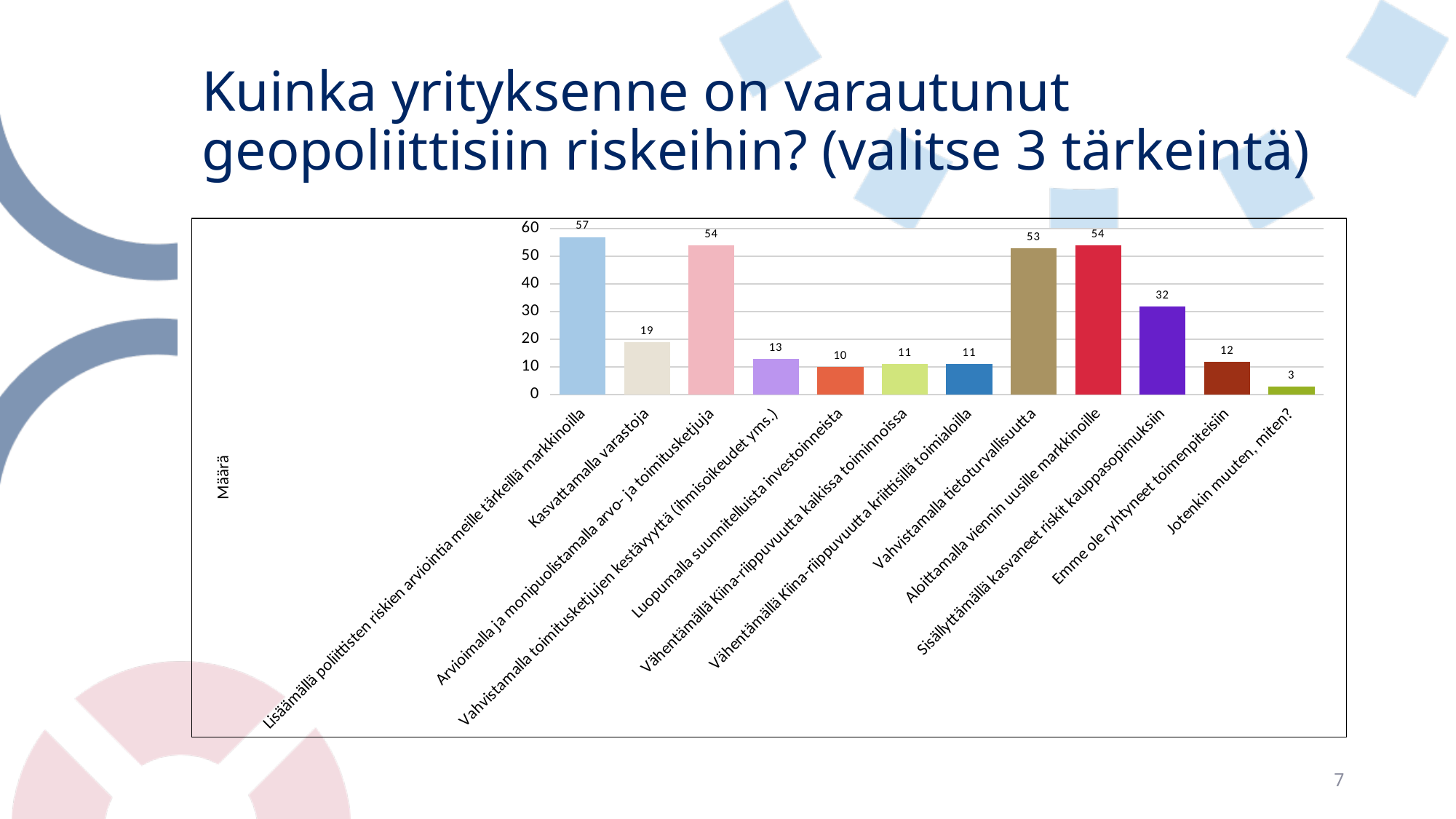
What kind of chart is shown on the slide? Bar chart What is the value for "Sisällyttämällä kasvaneet riskit kauppasopimuksiin"? 32 Is the value for "Aloittamalla viennin uusille markkinoille" greater or less than 50? greater Which category has the highest value? Lisäämällä poliittisten riskien arviointia meille tärkeillä markkinoilla Which is larger: the value for "Kasvattamalla varastoja" or the value for "Vahvistamalla toimitusketjujen kestävyyttä (ihmisoikeudet yms.)"? Kasvattamalla varastoja What is the value for "Kasvattamalla varastoja"? 19 What is the value for "Emme ole ryhtyneet toimenpiteisiin"? 12 Which category has the lowest value? Jotenkin muuten, miten? How many categories are shown in the chart? 12 What is the label on the vertical axis of the chart? Määrä What is the value for "Vahvistamalla tietoturvallisuutta"? 53 What is the difference between the values for "Lisäämällä poliittisten riskien arviointia meille tärkeillä markkinoilla" and "Sisällyttämällä kasvaneet riskit kauppasopimuksiin"? 25